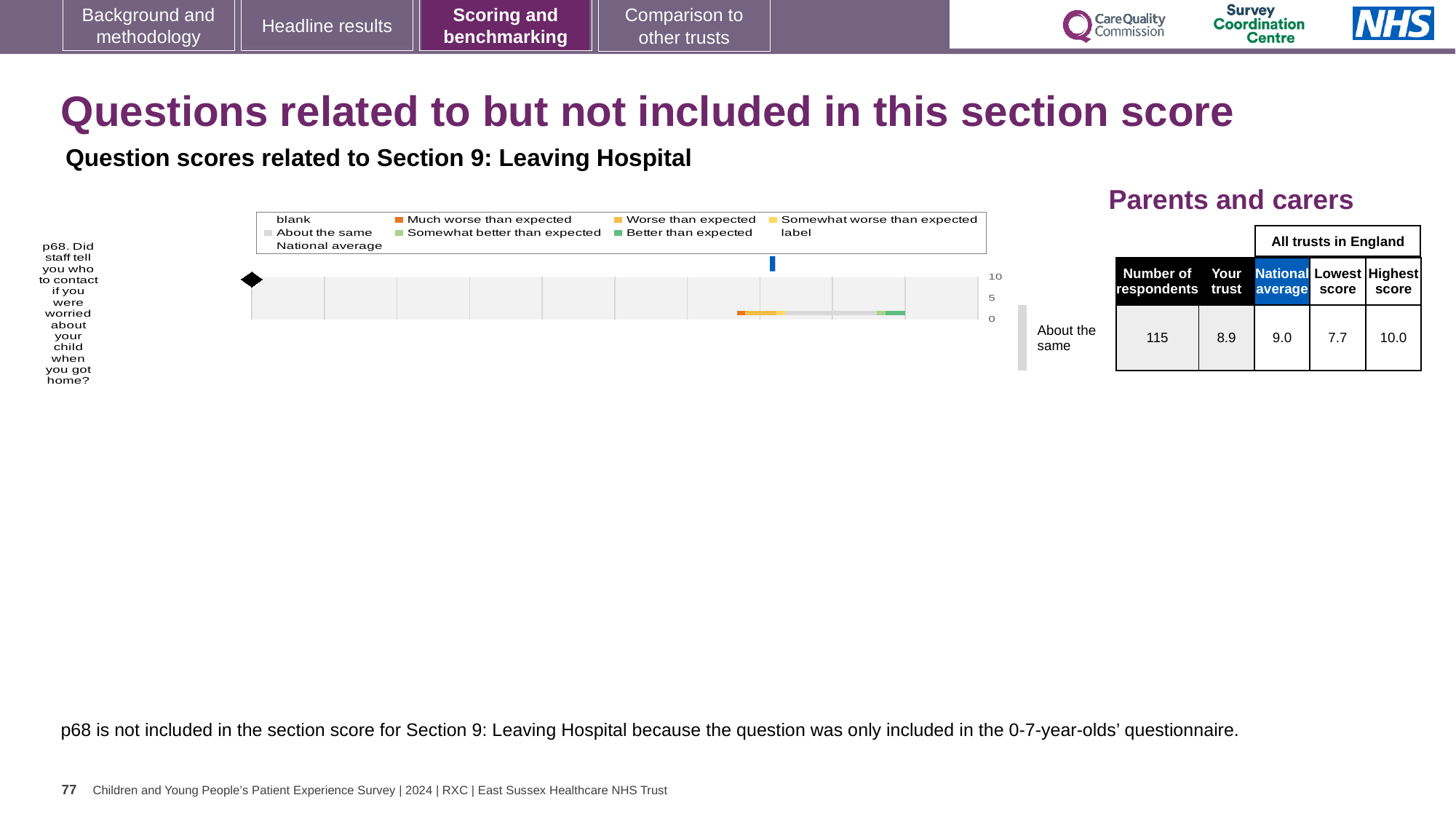
In the table beside the chart, what is the Highest score across all trusts in England for p68? 10.0 In the table beside the chart, what is the Lowest score across all trusts in England for p68? 7.7 Which is larger for p68, the 'Your trust' score or the National average? National average According to the label next to the chart, how does the trust's result for p68 compare with expectations? About the same What kind of chart is shown on the slide? bar chart What is the difference between the Highest score and the Lowest score for p68 in the table? 2.3 What is the highest value shown on the chart's axis? 10 In the table beside the chart, what is the National average score for p68? 9.0 In the table beside the chart, what is the 'Your trust' score for p68? 8.9 How many question categories are plotted on the chart? 1 In the table beside the chart, what is the number of respondents for p68? 115 Which question is plotted on the chart? p68. Did staff tell you who to contact if you were worried about your child when you got home?